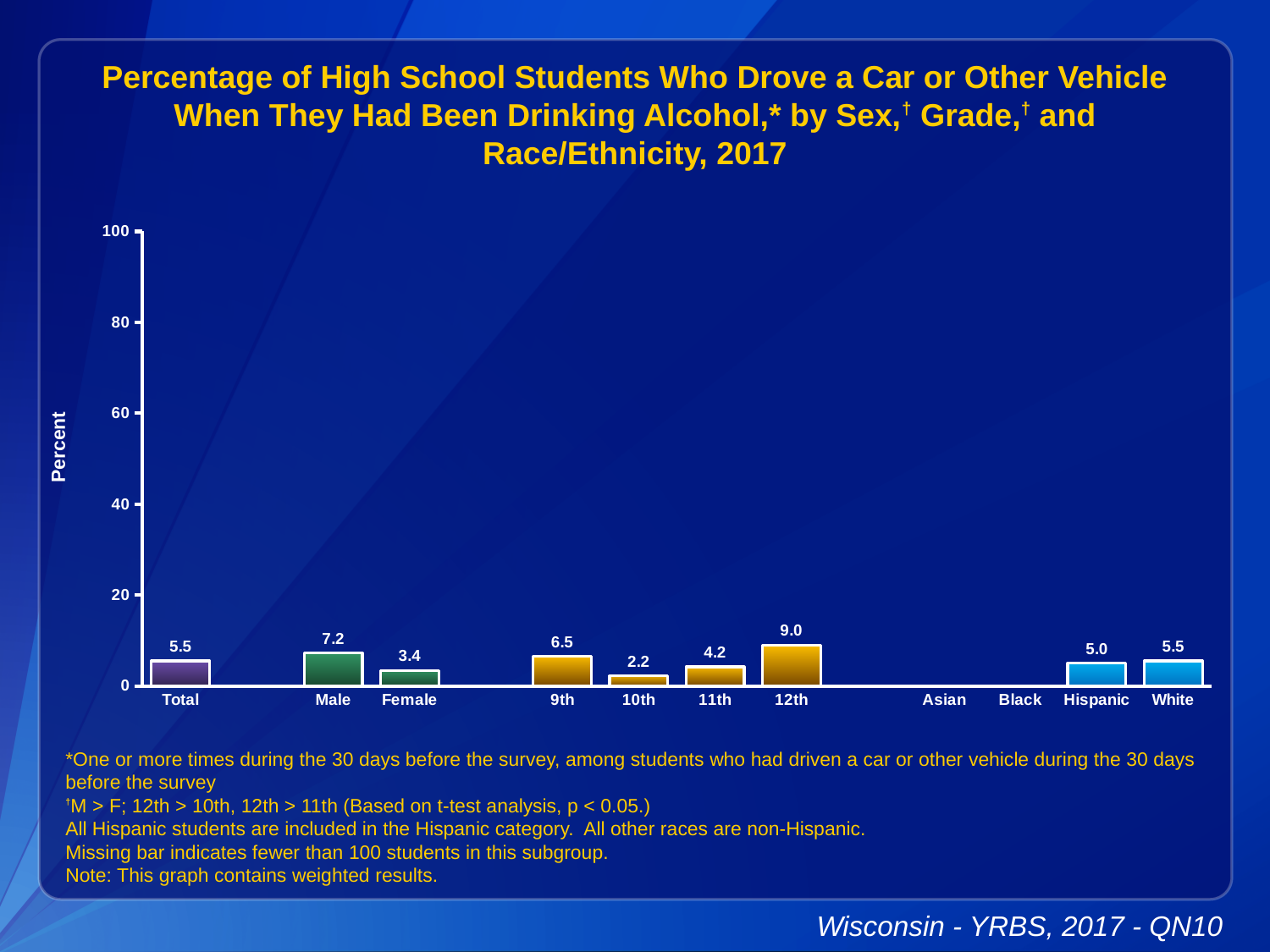
What is the difference between the Male and Female values? 3.8 Which category with a plotted bar has the lowest value? 10th What kind of chart is this? bar chart What is the value for 10th grade? 2.2 What is the value for Total? 5.5 Which category has the highest value? 12th Is the value for 12th grade greater or less than 20? less Which is larger, the value for 9th grade or the value for 11th grade? 9th What is the value for Hispanic? 5.0 What is the label on the y axis? Percent How many categories have a plotted bar? 9 What is the value for Male? 7.2